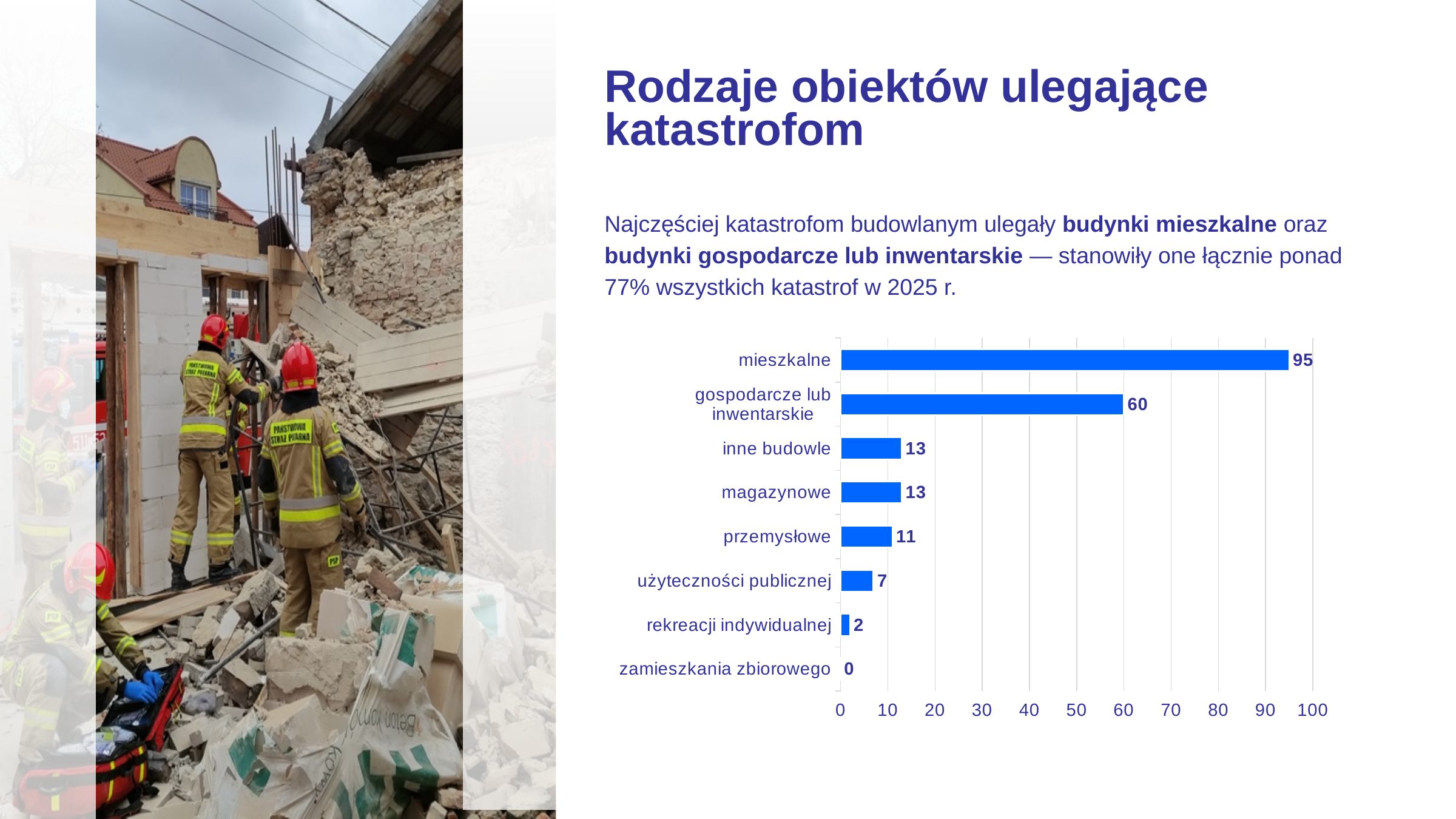
What kind of chart is shown on the slide? bar chart Which is larger, the value for przemysłowe or the value for użyteczności publicznej? przemysłowe What is the difference between the values for mieszkalne and gospodarcze lub inwentarskie? 35 What is the value for mieszkalne? 95 Which category has the lowest value? zamieszkania zbiorowego Is the value for gospodarcze lub inwentarskie greater or less than 50? greater What is the value for zamieszkania zbiorowego? 0 What is the value for gospodarcze lub inwentarskie? 60 What is the difference between the values for magazynowe and rekreacji indywidualnej? 11 How many categories are shown in the chart? 8 What is the value for użyteczności publicznej? 7 Which category has the highest value? mieszkalne